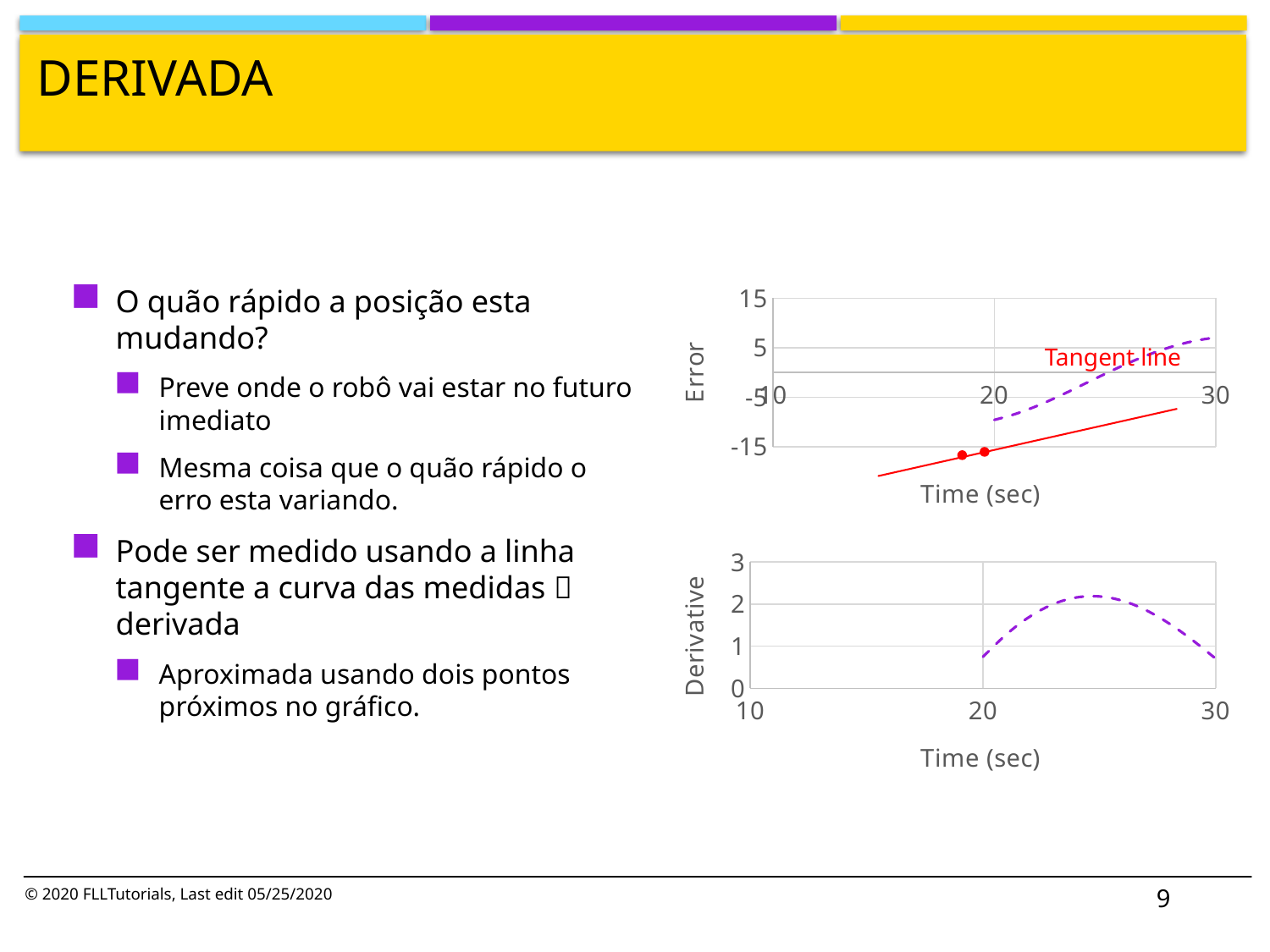
In the bottom chart, does the derivative curve rise or fall as time goes from 20 to 24 seconds? rise In the bottom chart, what is the label of the horizontal axis? Time (sec) In the bottom chart, is the derivative value at 25 seconds greater or less than 1? greater What kind of chart is the bottom chart (Derivative vs Time)? line chart In the top chart, is the error value at 20 seconds greater or less than -5? less What kind of chart is the top chart (Error vs Time)? line chart In the top chart, does the dashed error curve rise or fall as time goes from 20 to 30 seconds? rise In the top chart, is the error value at 30 seconds greater or less than -5? greater In the bottom chart, does the derivative curve rise or fall as time goes from 25 to 30 seconds? fall How many charts are shown on the slide? 2 In the top chart, what is the label of the vertical axis? Error